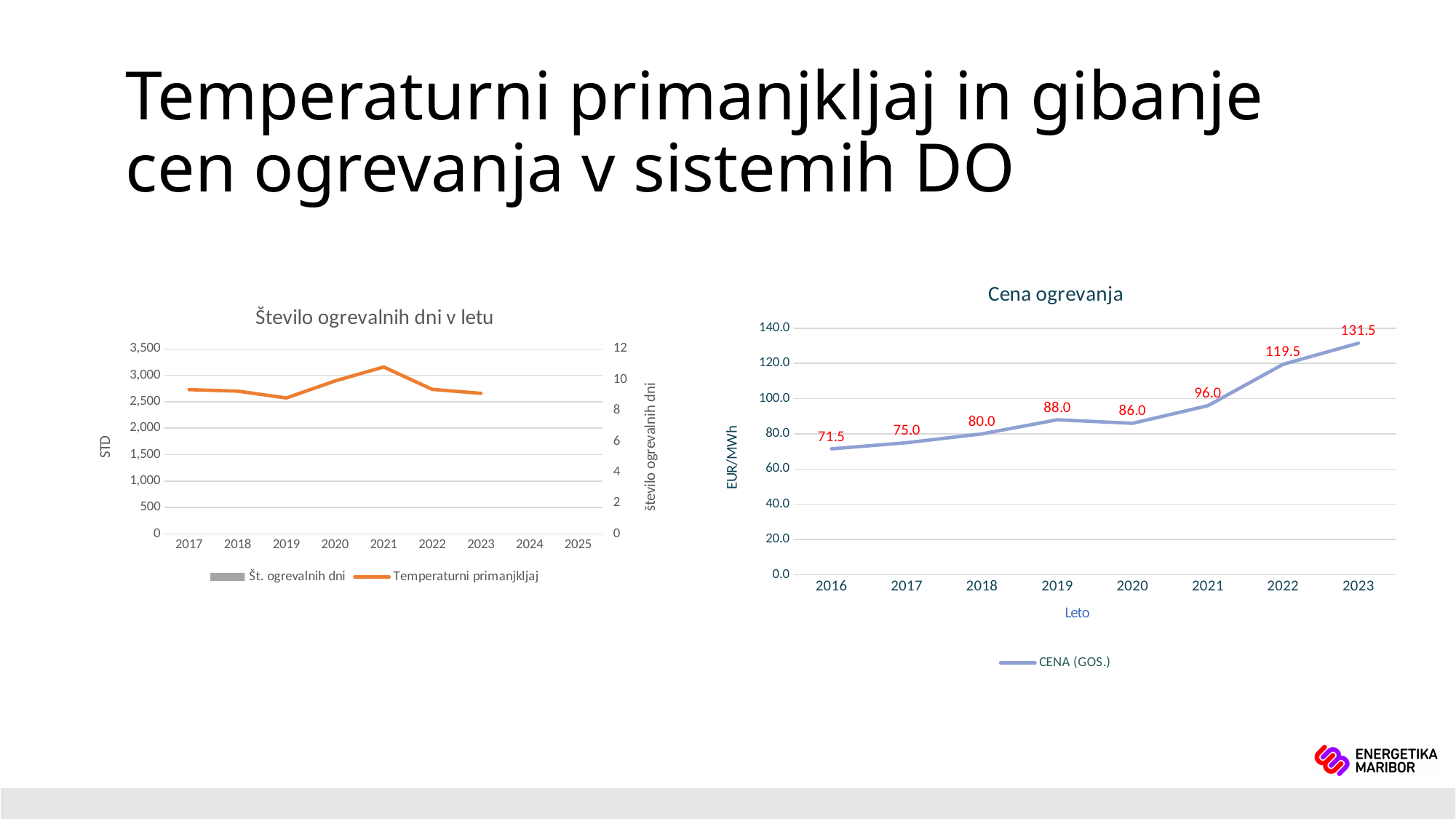
In the 'Cena ogrevanja' chart, what is the value for 2023? 131.5 In the 'Število ogrevalnih dni v letu' chart, is the value of the Temperaturni primanjkljaj line for 2021 greater or less than 3,000? greater In the 'Cena ogrevanja' chart, what is the value for 2020? 86.0 In the 'Cena ogrevanja' chart, what is the unit shown on the y axis? EUR/MWh In the 'Cena ogrevanja' chart, which year has the highest value? 2023 In the 'Cena ogrevanja' chart, which year has the lowest value? 2016 In the 'Število ogrevalnih dni v letu' chart, in which year does the Temperaturni primanjkljaj line reach its highest point? 2021 In the 'Cena ogrevanja' chart, which is larger, the value for 2019 or the value for 2020? 2019 In the 'Cena ogrevanja' chart, how many years are plotted on the x axis? 8 In the 'Število ogrevalnih dni v letu' chart, how many entries does the legend list? 2 In the 'Cena ogrevanja' chart, what is the value for 2016? 71.5 In the 'Cena ogrevanja' chart, what is the difference between the values for 2023 and 2022? 12.0